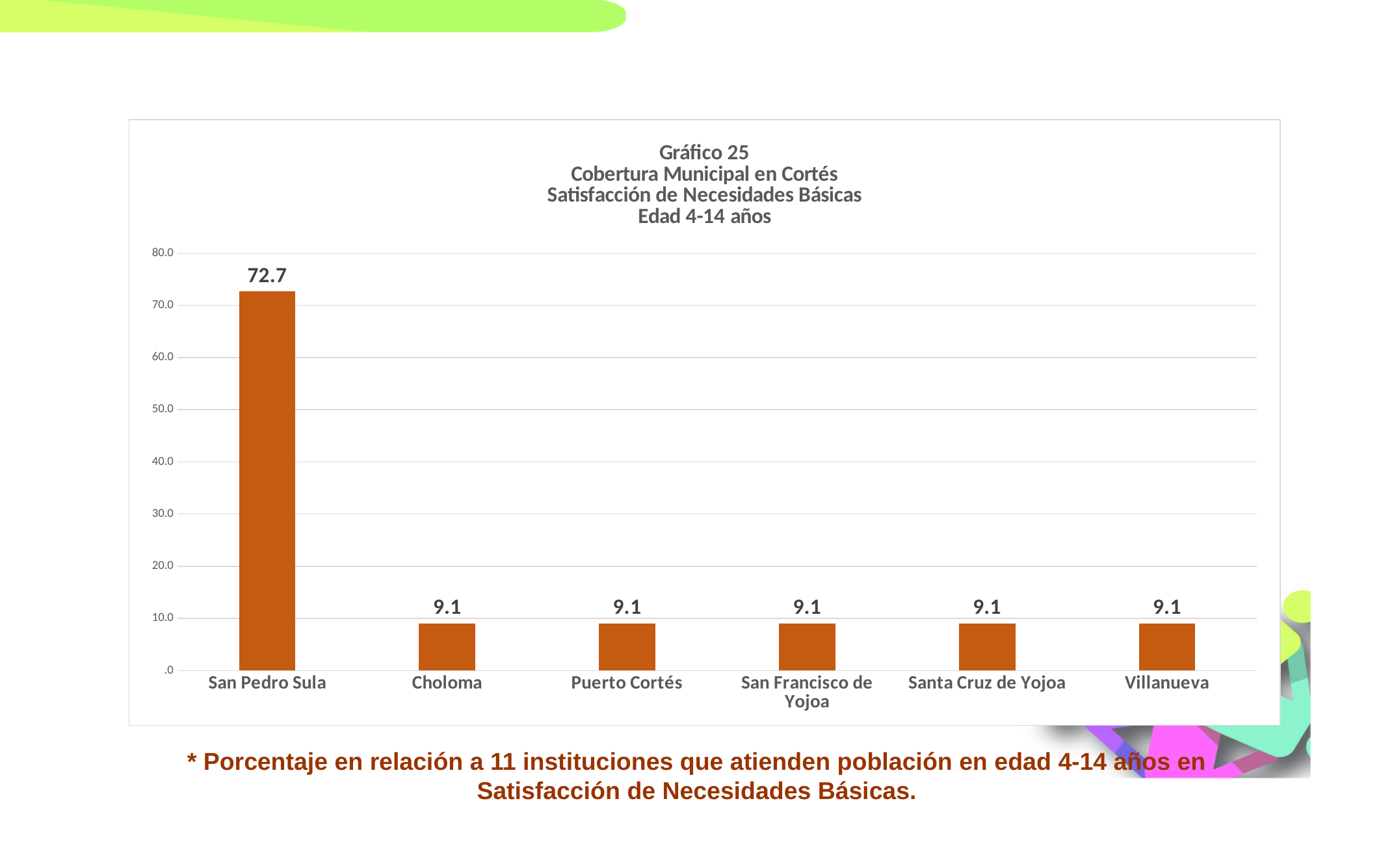
How many categories have a value of 9.1? 5 What is the difference between the values for San Pedro Sula and Puerto Cortés? 63.6 What kind of chart is shown on the slide? Bar chart What is the value for San Pedro Sula? 72.7 Which is larger, the value for San Pedro Sula or the value for Santa Cruz de Yojoa? San Pedro Sula Is the value for San Francisco de Yojoa greater or less than 10.0? less What is the value for Villanueva? 9.1 Is the value for San Pedro Sula greater or less than 70.0? greater What is the chart number given in the title? Gráfico 25 How many categories are shown on the x axis? 6 Which category has the highest value? San Pedro Sula What is the value for Choloma? 9.1